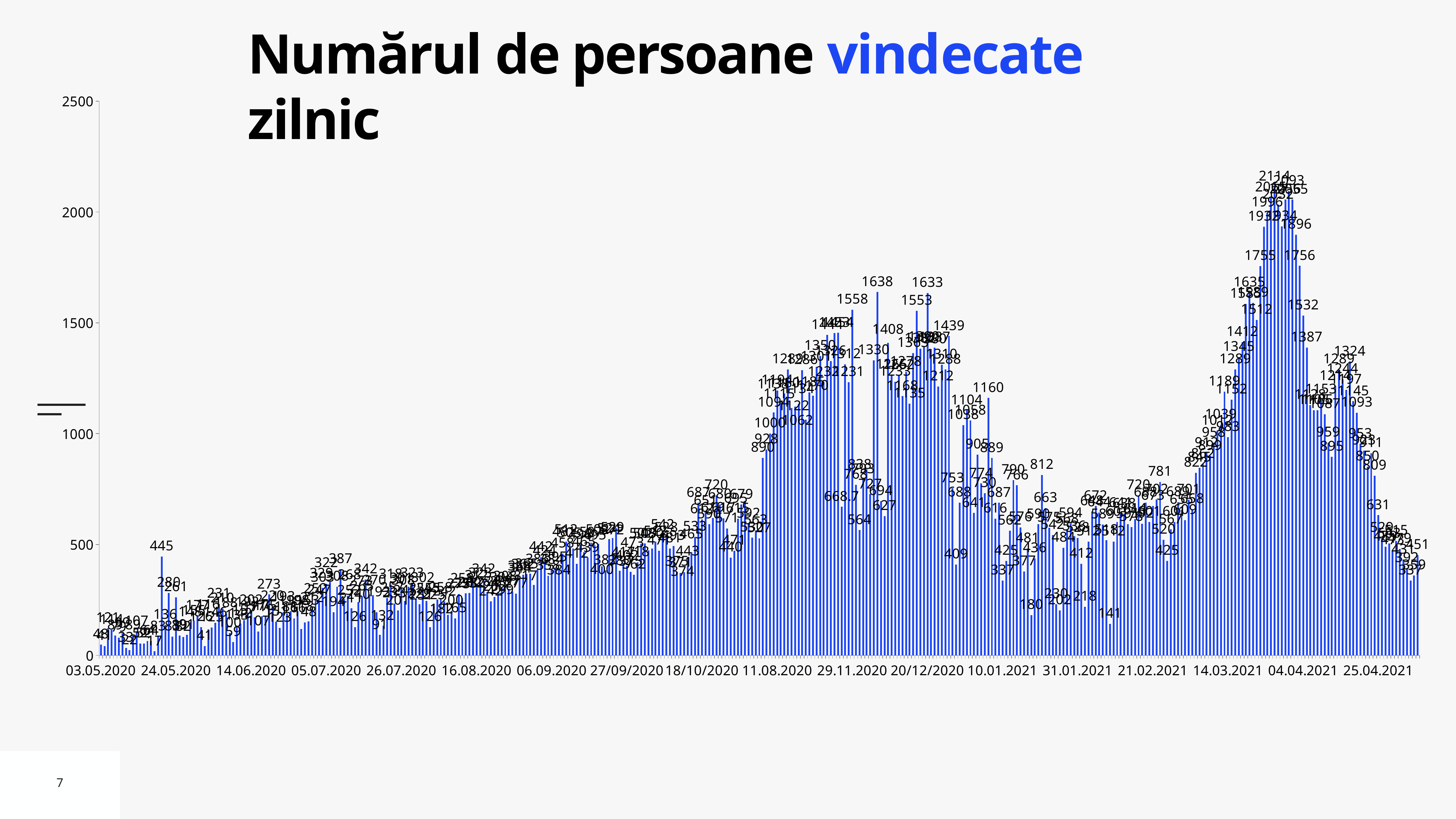
What is the first date label on the horizontal axis? 03.05.2020 Which is larger: the peak value around 04.04.2021 (2114) or the peak value around 29.11.2020 (1638)? 2114 What is the title of the chart? Numărul de persoane vindecate zilnic What is the highest daily value labelled on the chart? 2114 How many date labels are shown on the horizontal axis? 18 What is the last date label on the horizontal axis? 25.04.2021 Do the daily values generally rise or fall between 14.03.2021 and 04.04.2021? rise What kind of chart is shown on the slide? bar chart Is the tallest bar, near 04.04.2021, greater or less than 2000? greater What is the difference between the peak labelled 2114 and the peak labelled 1638? 476 Is the spike bar labelled 445 near 24.05.2020 greater or less than 500? less What is the highest value shown on the vertical axis? 2500